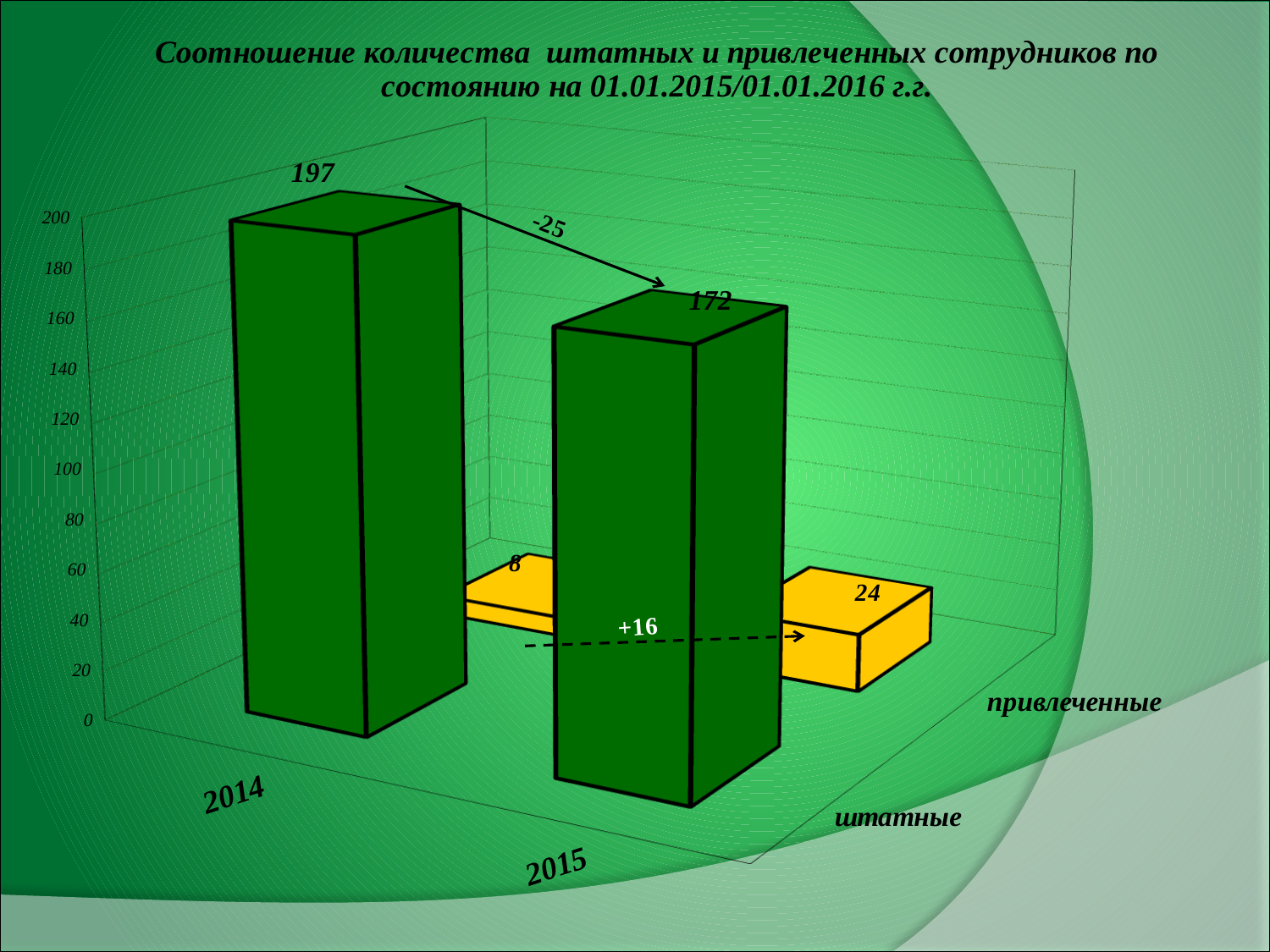
What is the value for штатные in 2015? 172 What is the value for привлеченные in 2015? 24 Which year has the lower value for привлеченные? 2014 Is the value for штатные in 2015 greater or less than 160? greater Which year has the higher value for штатные, 2014 or 2015? 2014 What is the value for привлеченные in 2014? 8 How many years are shown on the x axis? 2 What kind of chart is shown on the slide? bar chart What is the value for штатные in 2014? 197 By how much did the number of штатные change from 2014 to 2015? -25 How many series does the chart show? 2 By how much did the number of привлеченные change from 2014 to 2015? +16